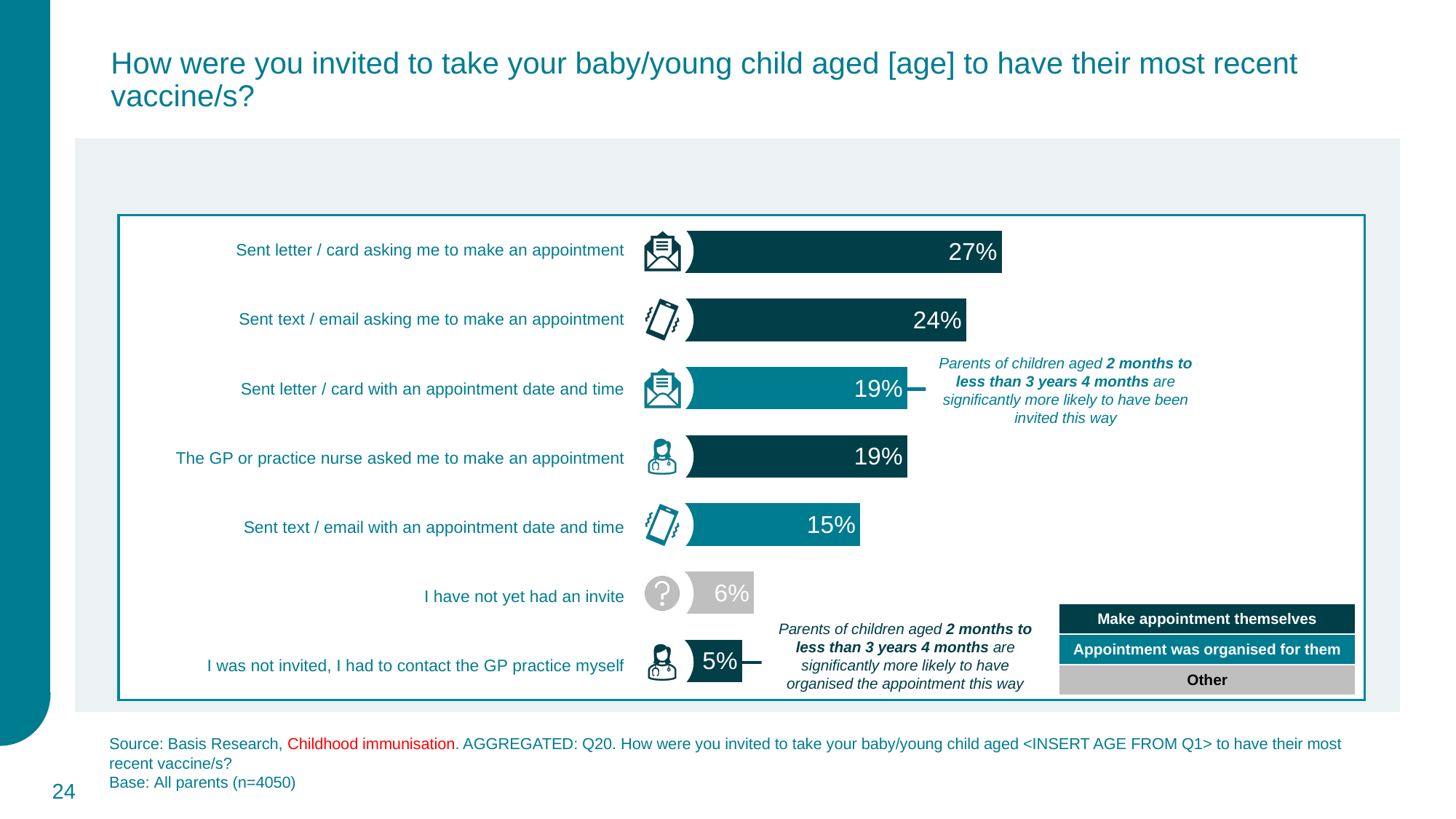
Which category has the lowest percentage? I was not invited, I had to contact the GP practice myself What percentage of parents were sent a letter / card asking them to make an appointment? 27% What type of chart is shown on the slide? Bar chart How many entries does the legend list? 3 What percentage of parents were sent a text / email with an appointment date and time? 15% What is the difference in percentage points between 'Sent letter / card asking me to make an appointment' and 'Sent text / email asking me to make an appointment'? 3 percentage points Which invitation method has the highest percentage? Sent letter / card asking me to make an appointment What percentage of parents said they have not yet had an invite? 6% Which is larger: the percentage for 'Sent text / email with an appointment date and time' or for 'The GP or practice nurse asked me to make an appointment'? The GP or practice nurse asked me to make an appointment What percentage of parents were not invited and had to contact the GP practice themselves? 5% Which legend category does the grey bar colour represent? Other How many categories are shown in the chart? 7